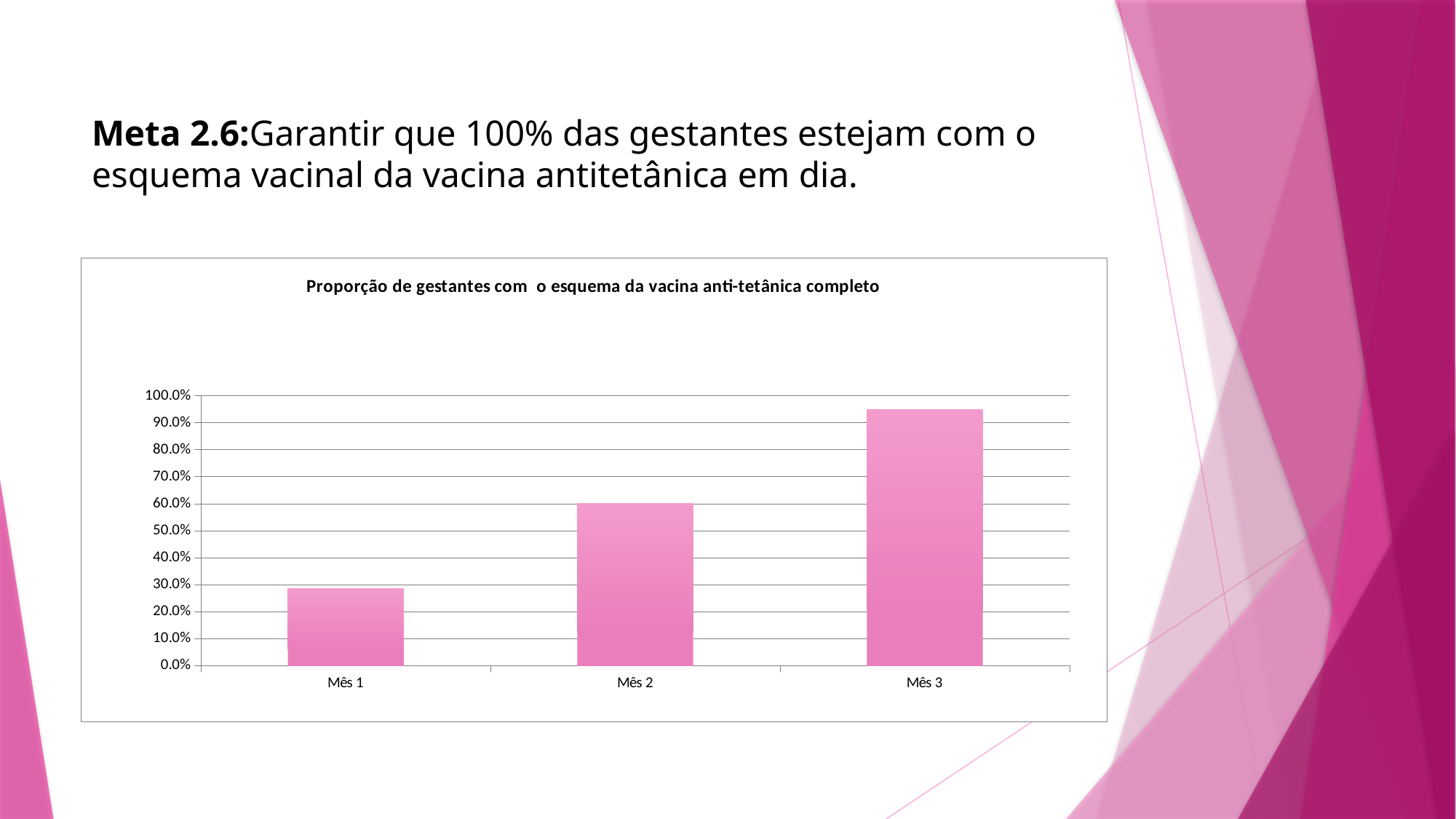
Which month has the lowest proportion in the chart? Mês 1 Is the value for Mês 2 greater or less than 50.0%? greater Do the values rise or fall from Mês 1 to Mês 3? rise Is the value for Mês 1 greater or less than 20.0%? greater How many categories are shown on the x axis of the chart? 3 What is the highest value shown on the y axis of the chart? 100.0% Which is larger, the value for Mês 1 or the value for Mês 2? Mês 2 What type of chart is shown on the slide? bar chart Is the value for Mês 2 greater or less than 70.0%? less What is the title of the chart? Proporção de gestantes com o esquema da vacina anti-tetânica completo Which month has the highest proportion in the chart? Mês 3